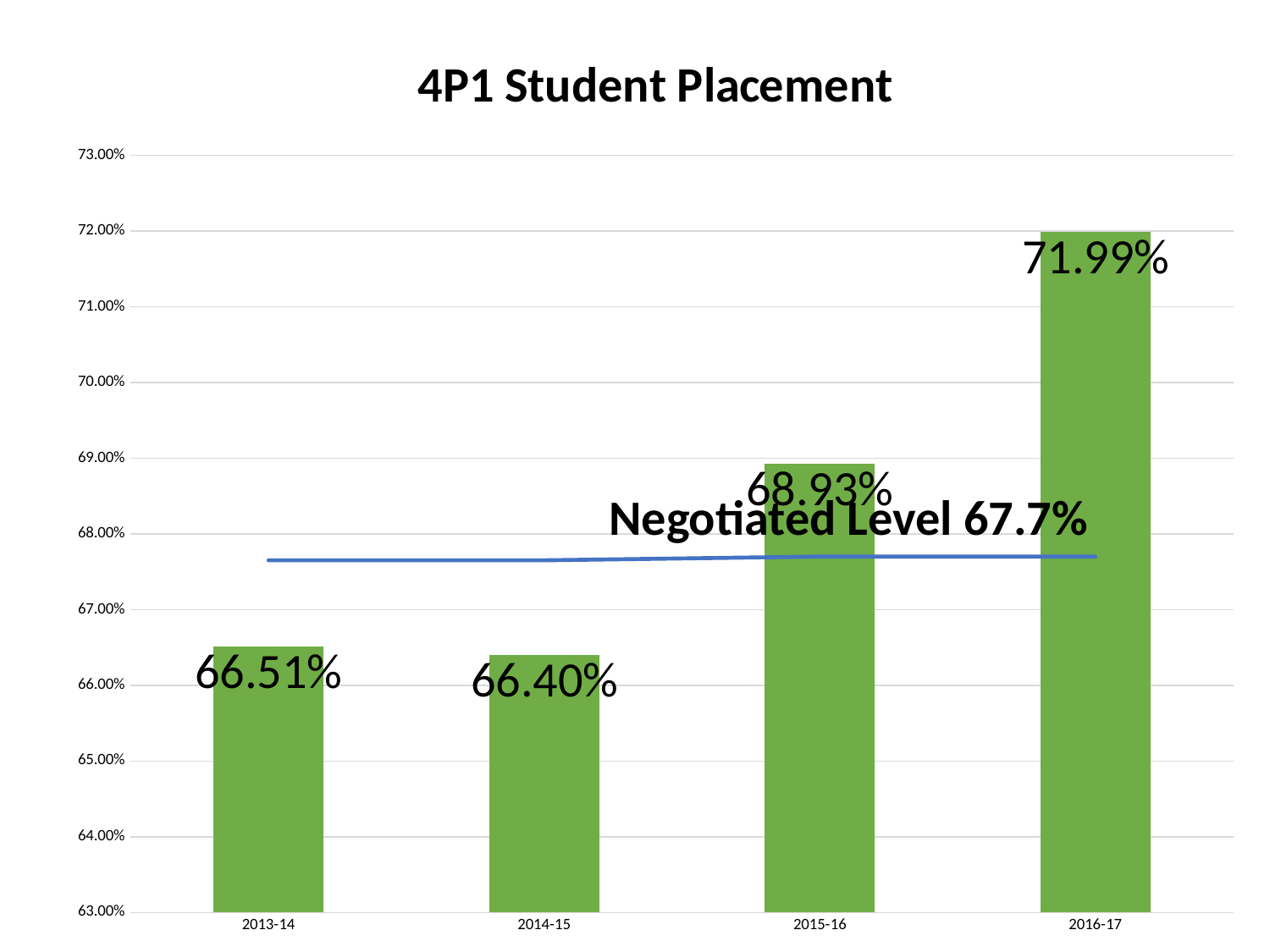
What is the 4P1 Student Placement value for 2014-15? 66.40% What is the difference between the 2016-17 and 2015-16 placement values? 3.06% How many years are shown on the x axis of the chart? 4 Which year has the lowest 4P1 Student Placement value? 2014-15 What is the Negotiated Level shown by the horizontal line on the chart? 67.7% Which year has the highest 4P1 Student Placement value? 2016-17 Is the placement value for 2016-17 greater or less than 71.00%? greater Which is larger, the placement value for 2013-14 or for 2014-15? 2013-14 What kind of chart is used to show the 4P1 Student Placement values? bar chart What is the 4P1 Student Placement value for 2015-16? 68.93% What is the 4P1 Student Placement value for 2016-17? 71.99% What is the 4P1 Student Placement value for 2013-14? 66.51%